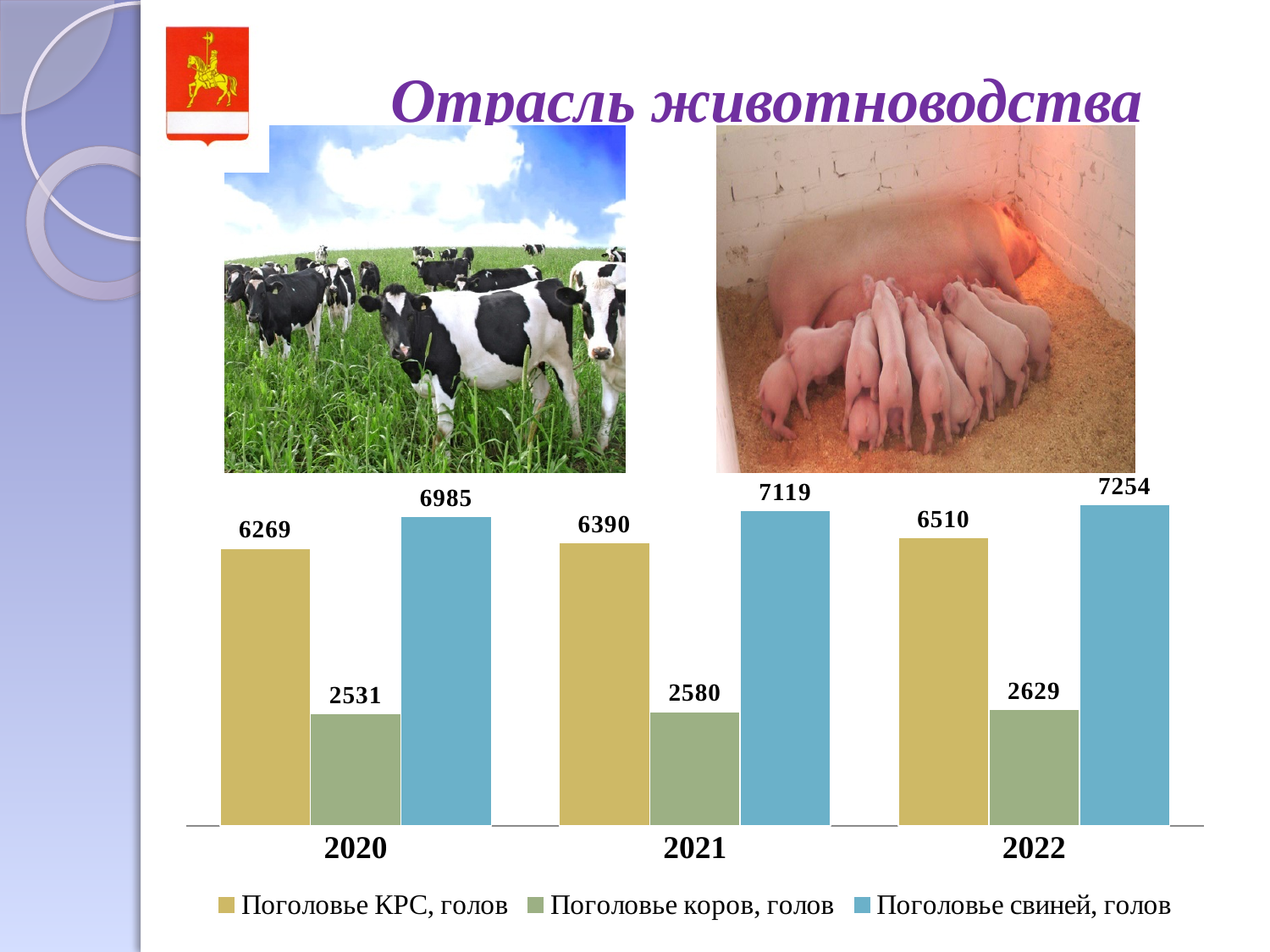
How many years are shown on the x axis? 3 What is the value for Поголовье КРС, голов in 2020? 6269 How many series does the legend list? 3 What is the difference between Поголовье КРС, голов and Поголовье коров, голов in 2021? 3810 What kind of chart is shown on the slide? bar chart Does Поголовье КРС, голов rise or fall from 2020 to 2022? rise What is the value for Поголовье коров, голов in 2021? 2580 What is the value for Поголовье свиней, голов in 2022? 7254 What is the difference between Поголовье свиней, голов in 2022 and in 2020? 269 Which is larger in 2021: Поголовье КРС, голов or Поголовье свиней, голов? Поголовье свиней, голов In which year is Поголовье свиней, голов highest? 2022 In which year is Поголовье коров, голов lowest? 2020